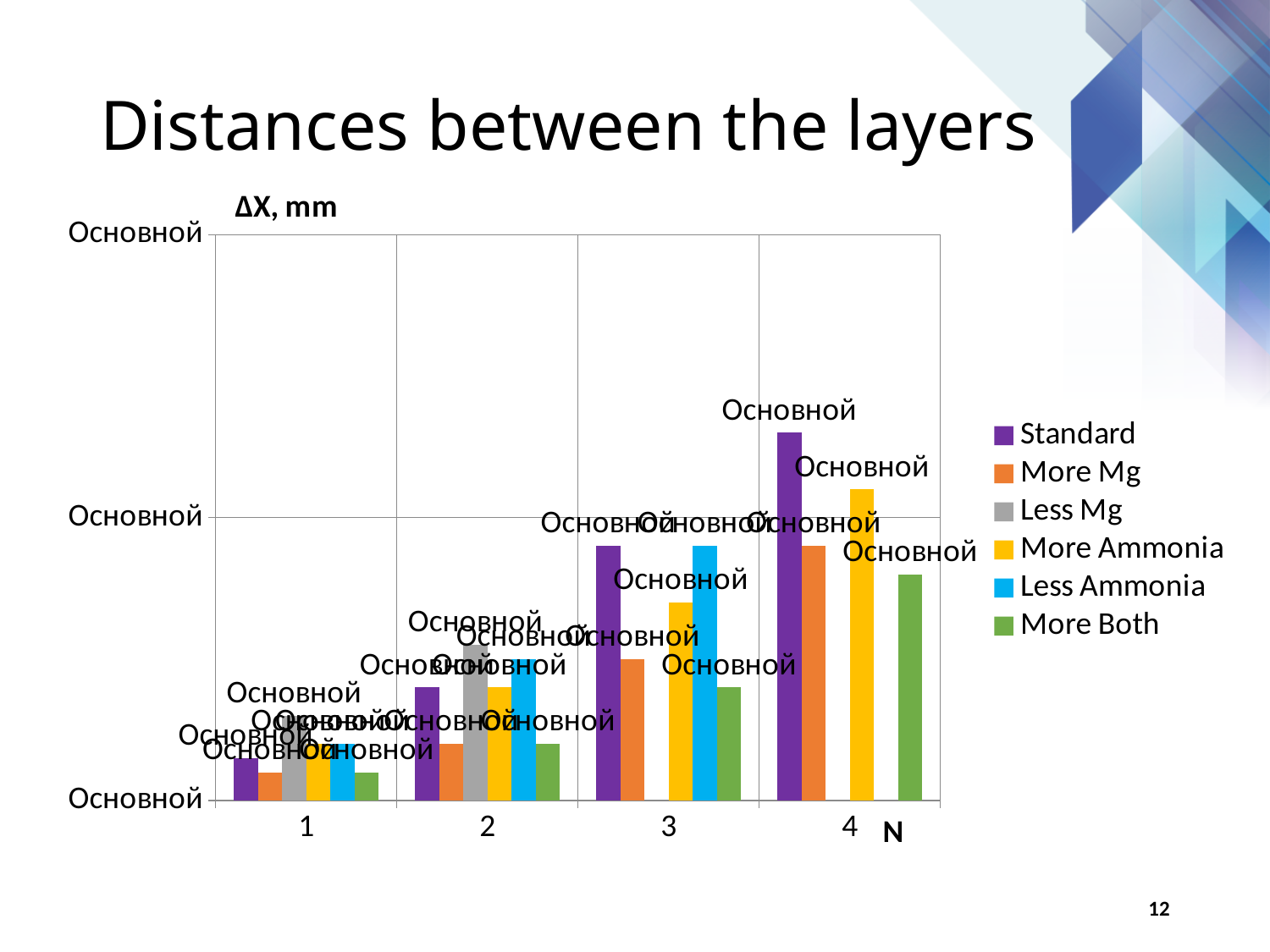
Which series has the lowest value at N = 3? More Both How many series does the legend list? 6 At N = 3, which is larger: Standard or More Mg? Standard What kind of chart is shown on the slide? bar chart How many categories are shown along the x axis? 4 Is the Standard value larger at N = 4 or at N = 1? N = 4 Do the Standard values rise or fall as N increases from 1 to 4? rise Which series has the highest value at N = 2? Less Mg Which series has the highest value at N = 4? Standard What is the label on the vertical axis? ΔX, mm Which series has the lowest value at N = 4? More Both Which series has the tallest bar in the whole chart? Standard